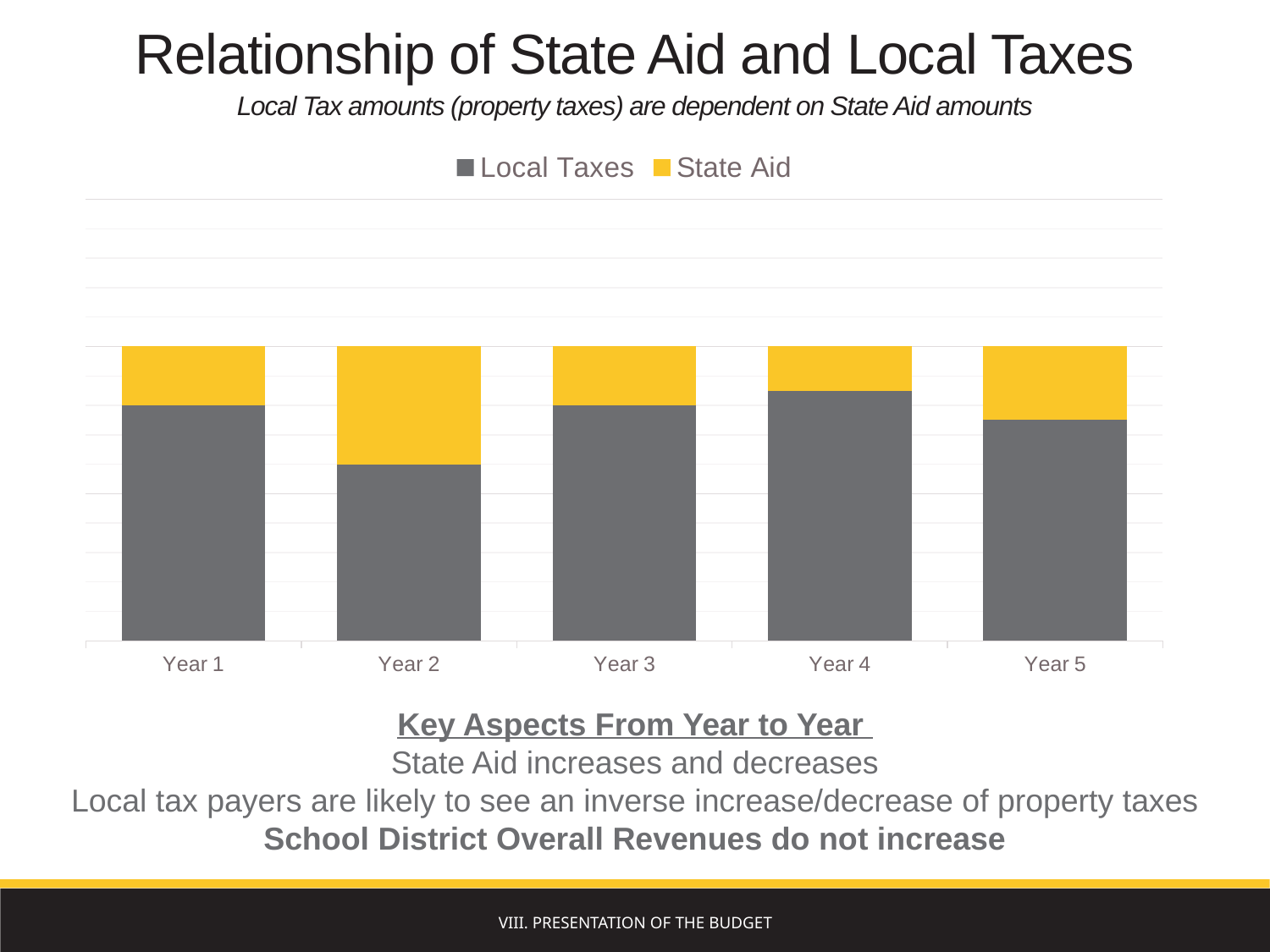
Is the Local Taxes portion larger in Year 1 or in Year 2? Year 1 Which colour represents State Aid in the chart? Yellow What kind of chart is shown on the slide? Stacked bar chart How many series does the chart's legend list? 2 How many years (categories) are shown on the x axis of the chart? 5 What are the two series named in the chart's legend? Local Taxes and State Aid In which year is the State Aid portion of the bar the smallest? Year 4 In which year is the Local Taxes portion of the bar the smallest? Year 2 In which year is the Local Taxes portion of the bar the largest? Year 4 Does the total height of the stacked bars change from Year 1 to Year 5? No, it stays the same In which year is the State Aid portion of the bar the largest? Year 2 Is the State Aid portion larger in Year 3 or in Year 5? Year 5